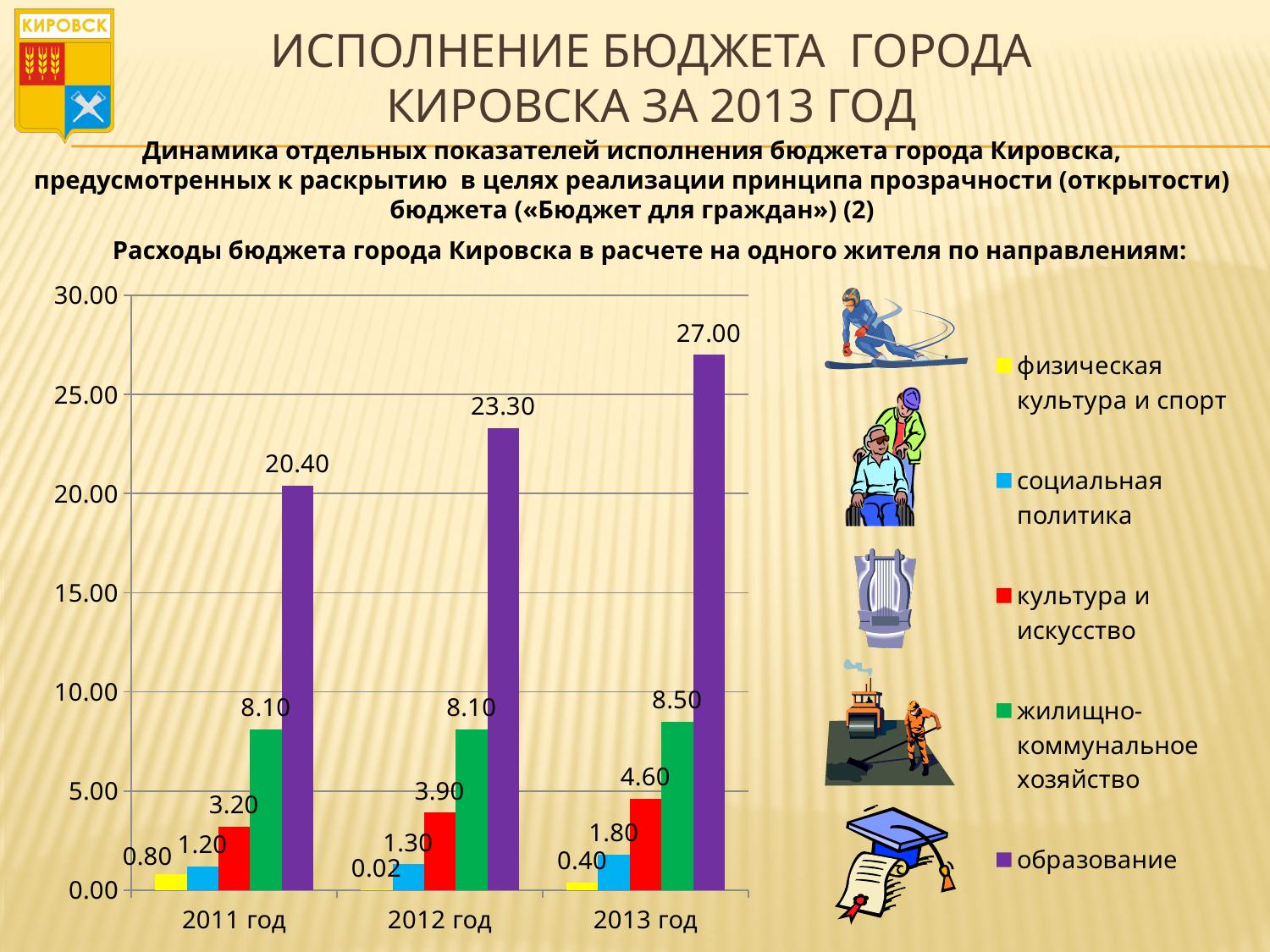
What is the value for физическая культура и спорт in 2012 год? 0.02 In which year is the value for образование the highest? 2013 год How many series does the legend list? 5 Which is larger: социальная политика in 2013 год or культура и искусство in 2011 год? культура и искусство in 2011 год What kind of chart is shown on the slide? bar chart Do the values for образование rise or fall from 2011 год to 2013 год? rise What is the value for образование in 2013 год? 27.00 In which year is the value for физическая культура и спорт the lowest? 2012 год How many years are shown on the x axis? 3 What is the value for жилищно-коммунальное хозяйство in 2011 год? 8.10 What is the difference between the образование values for 2013 год and 2011 год? 6.60 What is the value for культура и искусство in 2013 год? 4.60